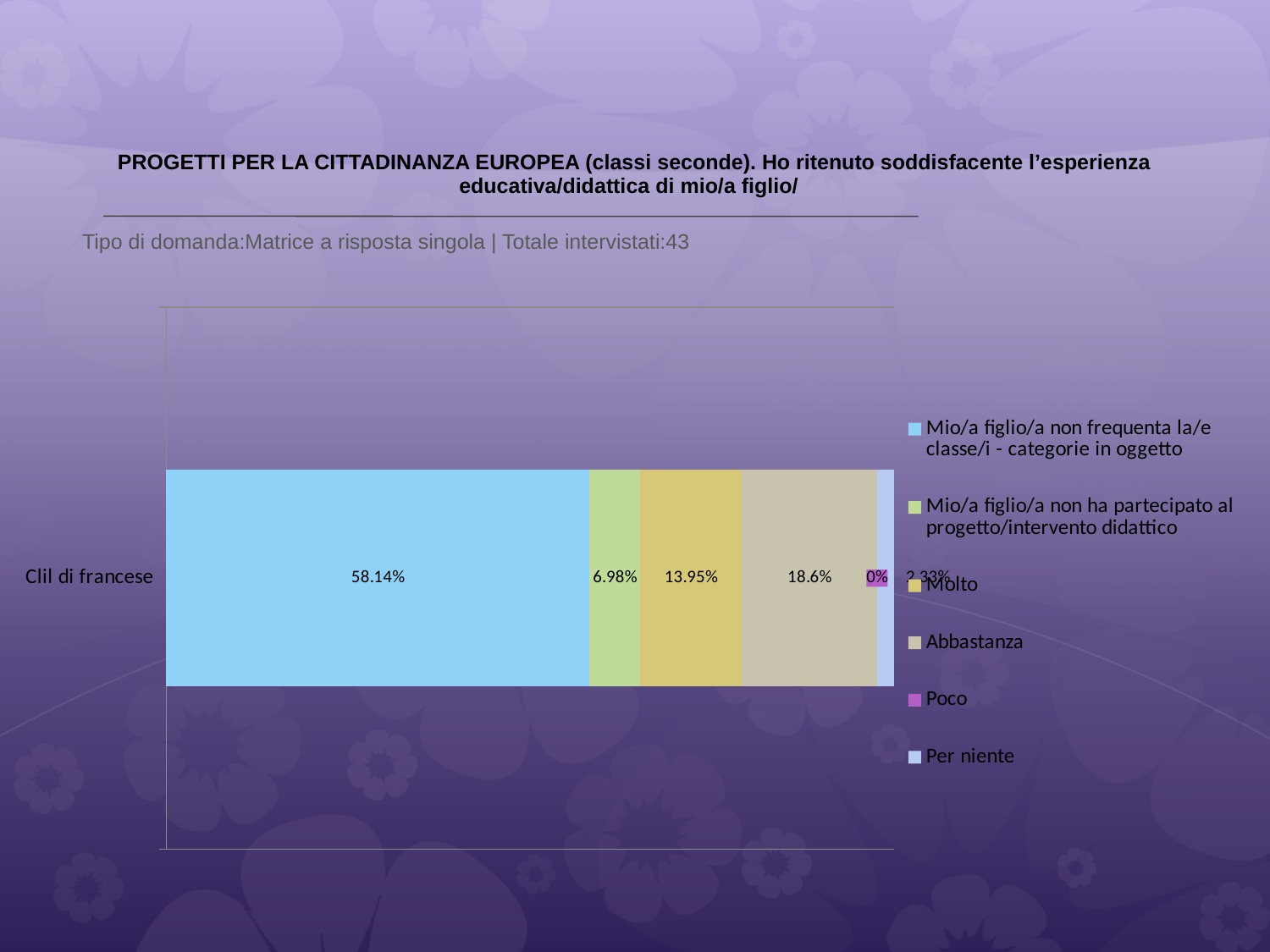
Which series has the smallest segment in the Clil di francese bar? Poco What is the value for 'Poco' in the Clil di francese bar? 0% What is the value for 'Abbastanza' in the Clil di francese bar? 18.6% What is the difference between the 'Abbastanza' and 'Molto' values? 4.65% Which is larger, the value for 'Molto' or the value for 'Abbastanza'? Abbastanza What is the value for 'Mio/a figlio/a non frequenta la/e classe/i - categorie in oggetto'? 58.14% What is the value for 'Molto' in the Clil di francese bar? 13.95% Which series has the largest segment in the Clil di francese bar? Mio/a figlio/a non frequenta la/e classe/i - categorie in oggetto What kind of chart is shown on the slide? Stacked bar chart How many categories are shown on the vertical axis of the chart? 1 What is the value for 'Mio/a figlio/a non ha partecipato al progetto/intervento didattico'? 6.98% How many series does the legend list? 6